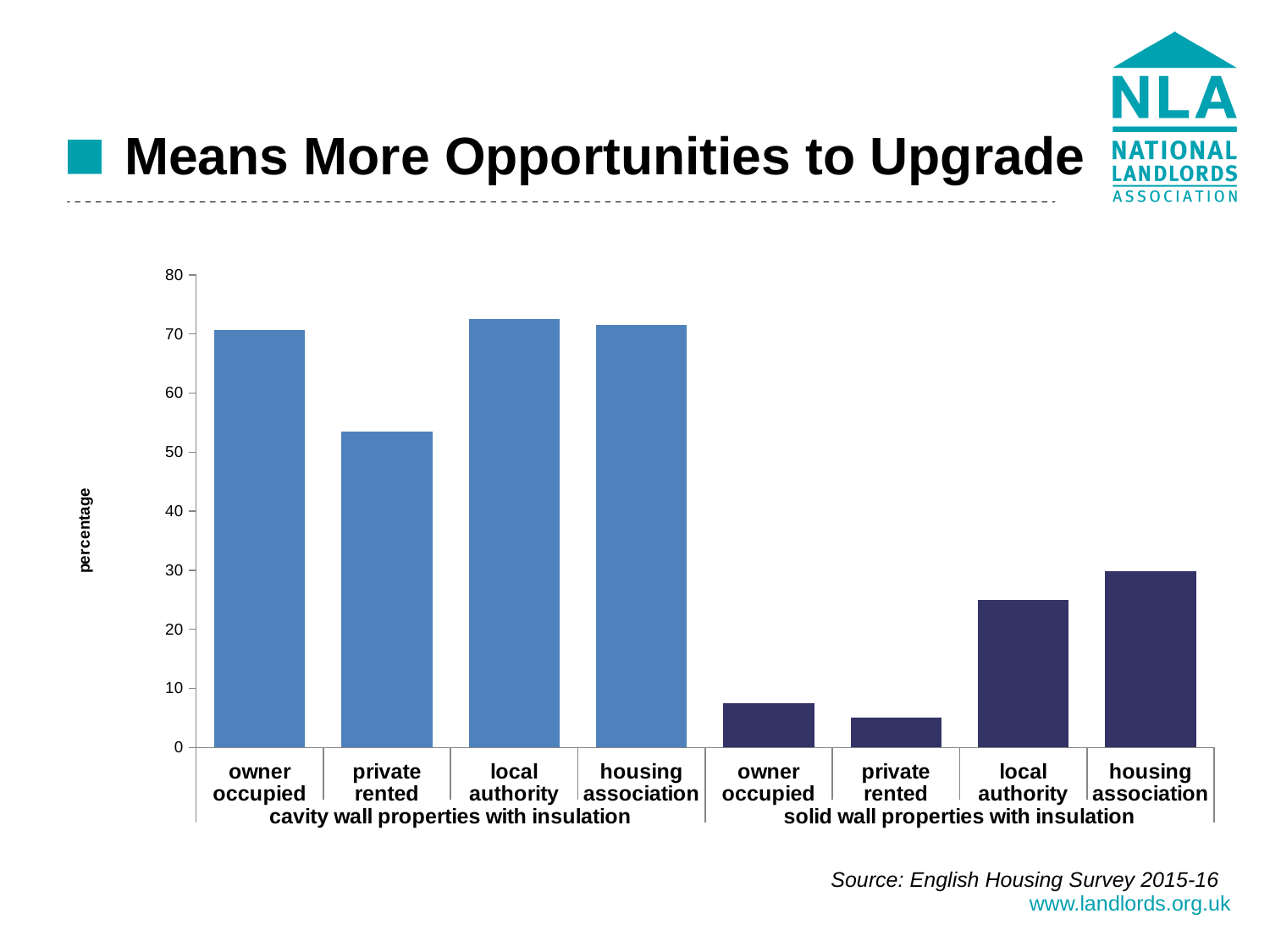
Is the value for owner occupied under 'solid wall properties with insulation' greater or less than 10? less Is the value for local authority under 'solid wall properties with insulation' greater or less than 20? greater Is the value for housing association under 'solid wall properties with insulation' greater or less than 40? less Within the 'solid wall properties with insulation' group, which tenure has the highest value? housing association Which is larger: the value for private rented under cavity wall properties with insulation, or the value for private rented under solid wall properties with insulation? cavity wall properties with insulation How many bars are plotted in the chart? 8 What is the label on the vertical axis of the chart? percentage Within the 'cavity wall properties with insulation' group, which tenure has the lowest value? private rented How many tenure categories are shown within the 'cavity wall properties with insulation' group? 4 What kind of chart is shown on the slide? bar chart